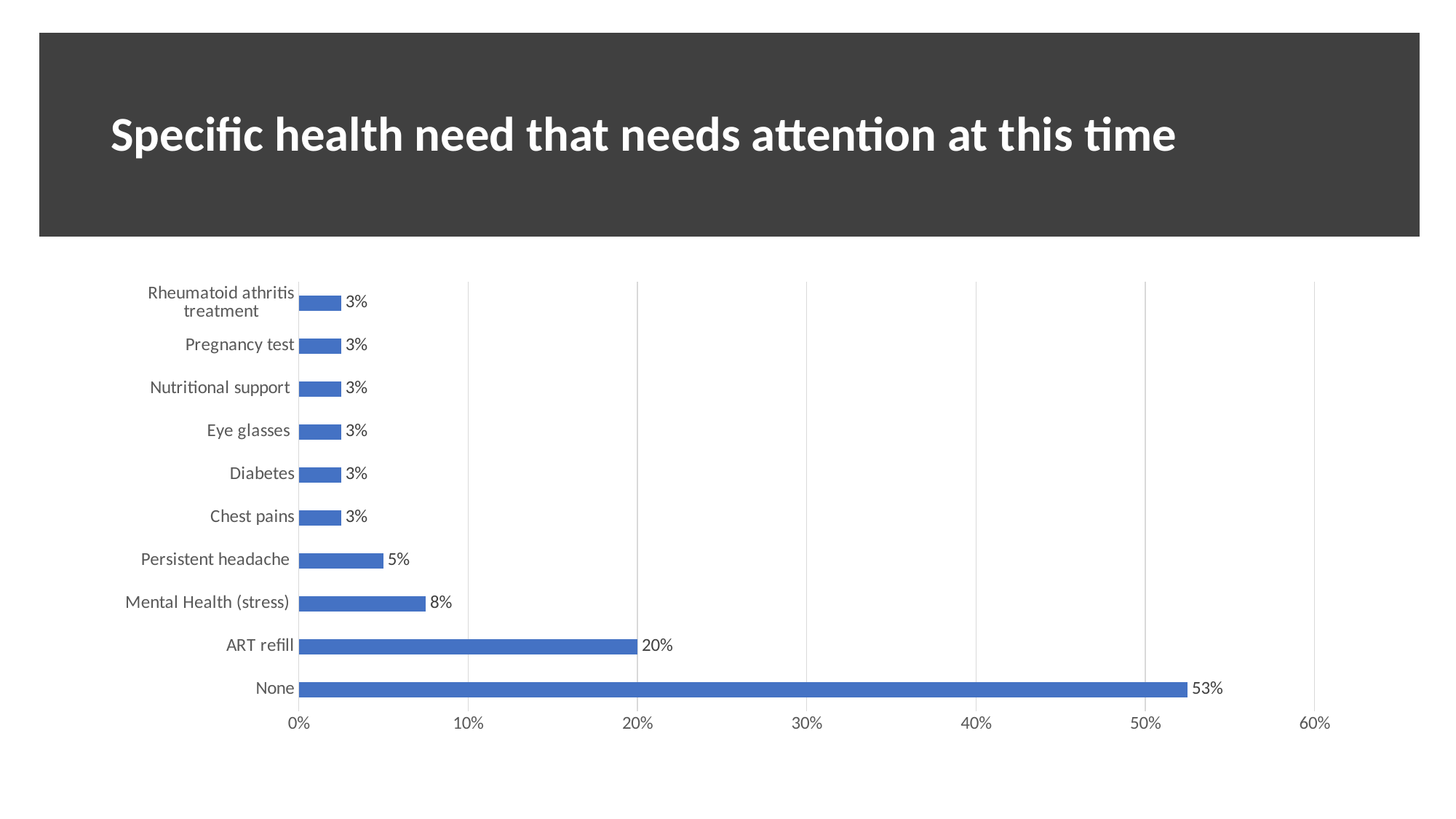
What is the value for ART refill? 20% Which category has the highest value? None What is the value for None? 53% What kind of chart is shown on the slide? Bar chart What is the value for Persistent headache? 5% What is the difference between the values for None and ART refill? 33% What is the title of the slide? Specific health need that needs attention at this time What is the difference between the values for Mental Health (stress) and Persistent headache? 3% How many categories are shown in the chart? 10 Is the value for None greater or less than 50%? greater Which is larger, the value for ART refill or the value for Mental Health (stress)? ART refill What is the value for Mental Health (stress)? 8%